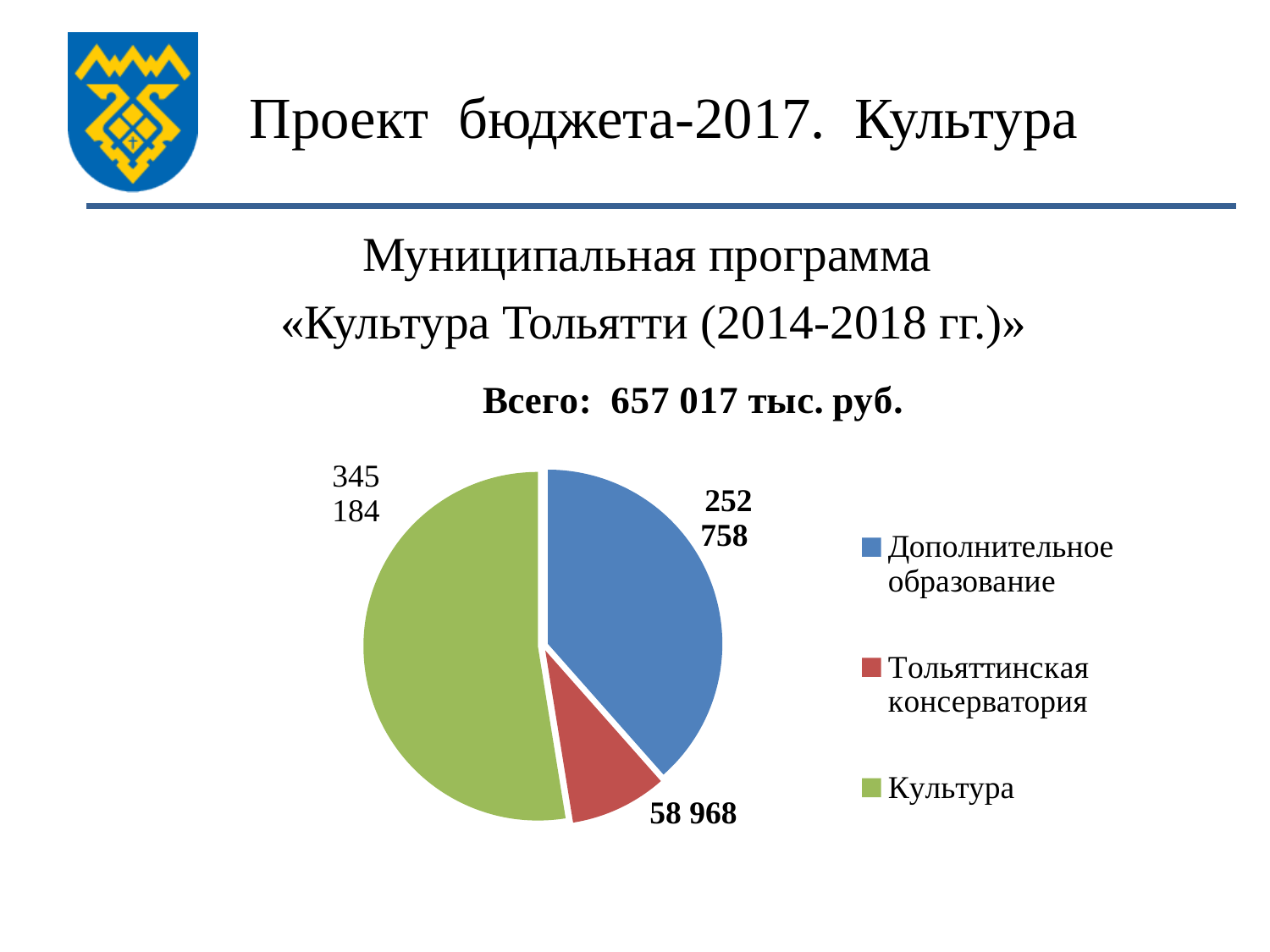
Which is larger: the value for «Дополнительное образование» or the value for «Тольяттинская консерватория»? Дополнительное образование What total amount («Всего») is stated above the pie chart? 657 017 тыс. руб. What type of chart is shown on the slide? Pie chart Which category has the largest slice in the pie chart? Культура What is the value for «Тольяттинская консерватория» in the pie chart? 58 968 Which category has the smallest slice in the pie chart? Тольяттинская консерватория What is the value for «Культура» in the pie chart? 345 184 What is the difference between the values for «Дополнительное образование» and «Тольяттинская консерватория»? 193 790 How many categories does the pie chart show? 3 What is the value for «Дополнительное образование» in the pie chart? 252 758 What colour is the slice for «Культура» in the pie chart? Green What is the difference between the values for «Культура» and «Дополнительное образование»? 92 426